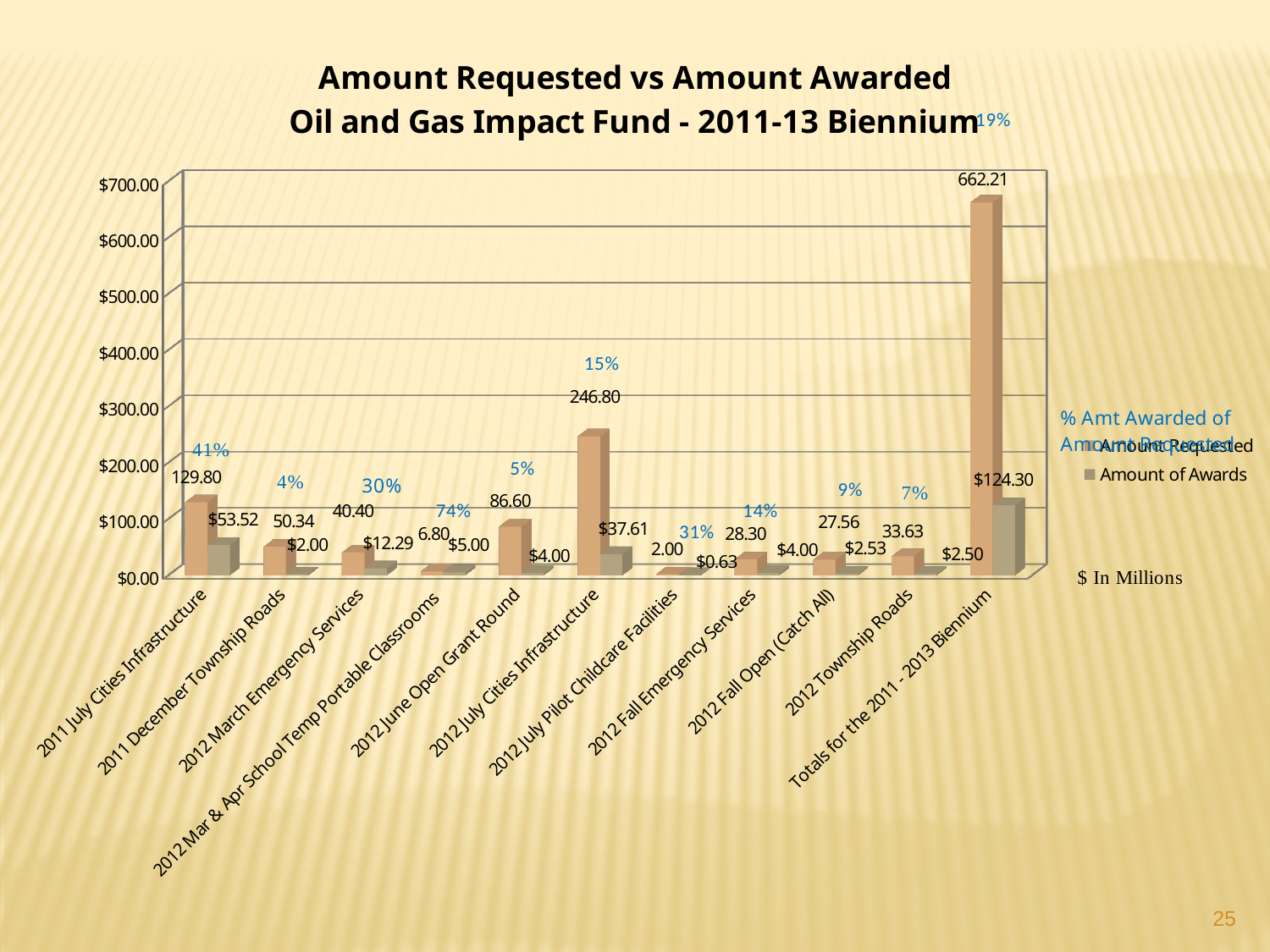
What kind of chart is shown on the slide? Bar chart What is the Amount Requested for 2012 July Cities Infrastructure? 246.80 Is the Amount Requested for 2012 July Cities Infrastructure greater or less than $200.00? greater Which is larger: the Amount Requested for 2011 December Township Roads or for 2012 March Emergency Services? 2011 December Township Roads Which category has the lowest Amount of Awards? 2012 July Pilot Childcare Facilities What is the Amount of Awards for 2012 March Emergency Services? $12.29 What is the Amount of Awards for 2011 July Cities Infrastructure? $53.52 Which category has the highest Amount Requested? Totals for the 2011 - 2013 Biennium How many categories are shown on the x axis of the chart? 11 What is the difference between the Amount Requested and the Amount of Awards for 2011 July Cities Infrastructure? 76.28 What is the Amount Requested for 2012 June Open Grant Round? 86.60